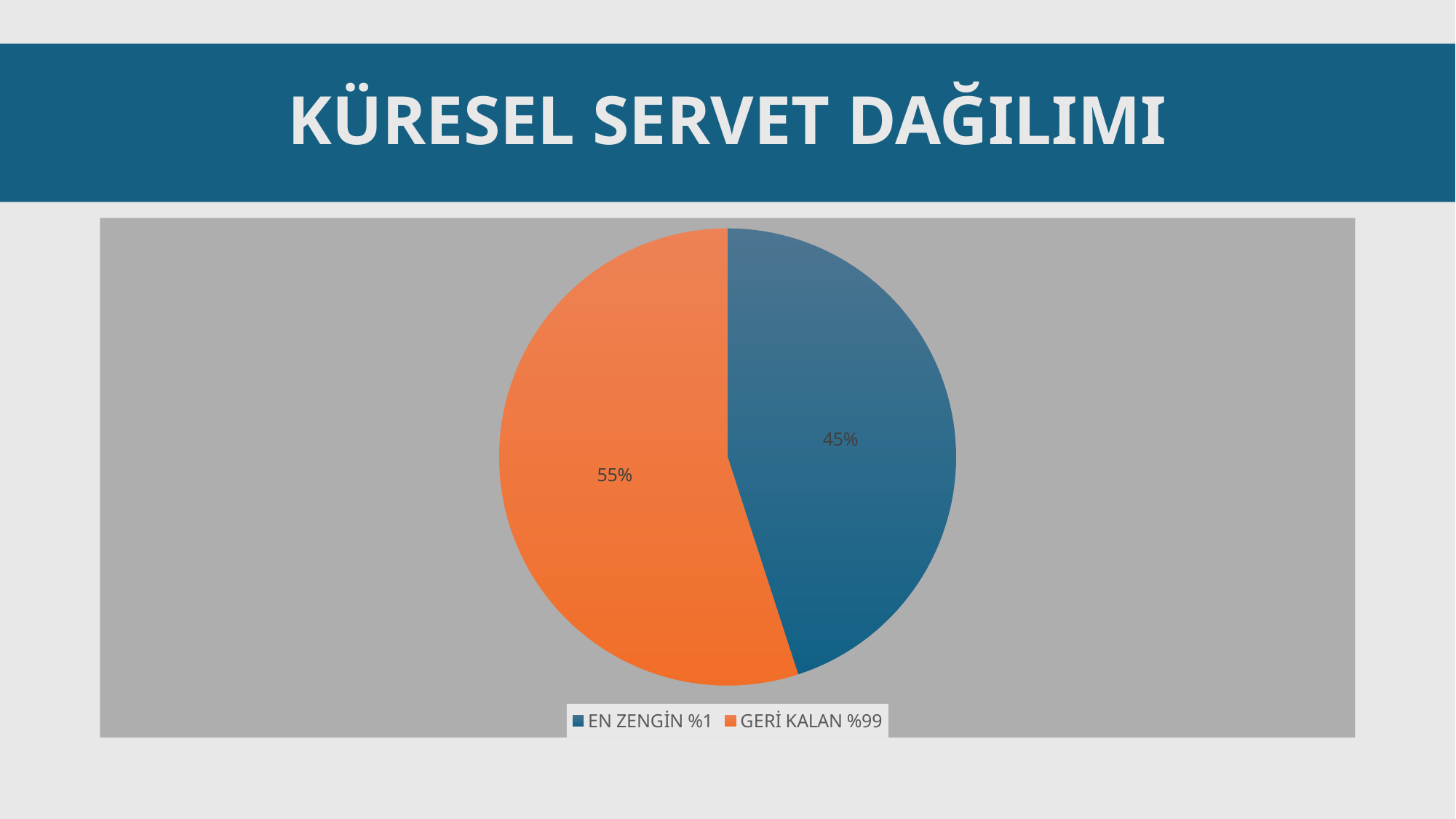
Which slice is the smallest? EN ZENGİN %1 Which slice is the largest? GERİ KALAN %99 What colour is the EN ZENGİN %1 slice? blue Which is larger, the EN ZENGİN %1 slice or the GERİ KALAN %99 slice? GERİ KALAN %99 What kind of chart is shown on the slide? pie chart What is the title of the slide containing the chart? KÜRESEL SERVET DAĞILIMI How many entries does the legend list? 2 What share of the pie does GERİ KALAN %99 hold? 55% How many slices does the pie chart have? 2 What is the difference in percentage points between the GERİ KALAN %99 slice and the EN ZENGİN %1 slice? 10 What share of the pie does EN ZENGİN %1 hold? 45%